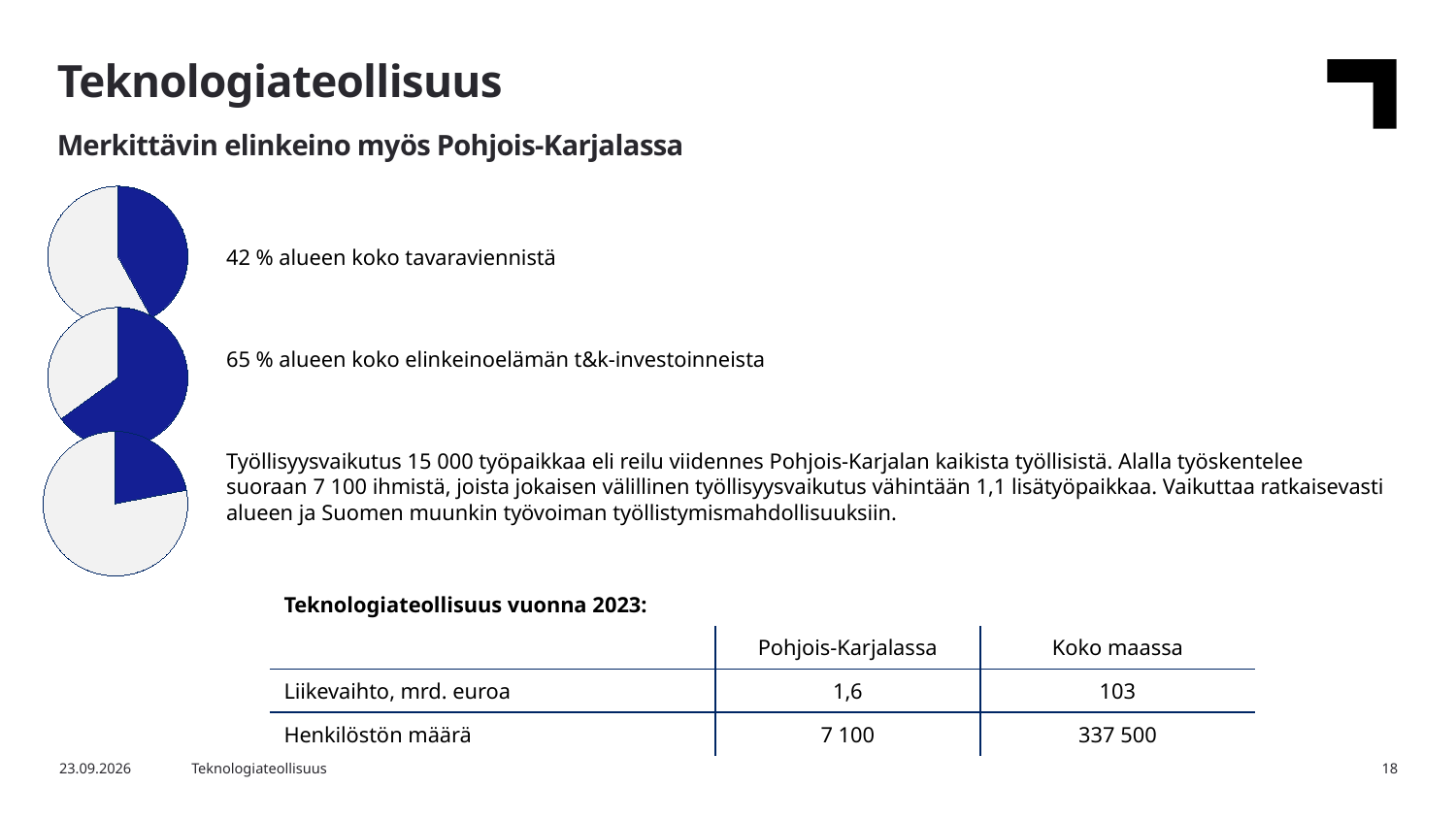
In the top pie chart, what share of the region's total goods exports does the blue slice represent? 42 % How many slices does each pie chart on the slide have? 2 In the middle pie chart, does the blue slice cover more or less than half of the pie? more In the middle pie chart, what share of the region's business R&D investments does the blue slice represent? 65 % Is the blue slice larger in the top pie chart or in the bottom pie chart? the top pie chart What kind of chart is shown on the left side of the slide? pie chart Which of the three pie charts has the smallest blue slice? the bottom pie chart Is the blue slice larger in the top pie chart or in the middle pie chart? the middle pie chart How many pie charts are on the slide? 3 What colour is used for the highlighted slice in the pie charts? blue Which of the three pie charts has the largest blue slice? the middle pie chart What colour is the remaining (non-highlighted) part of each pie chart? light grey